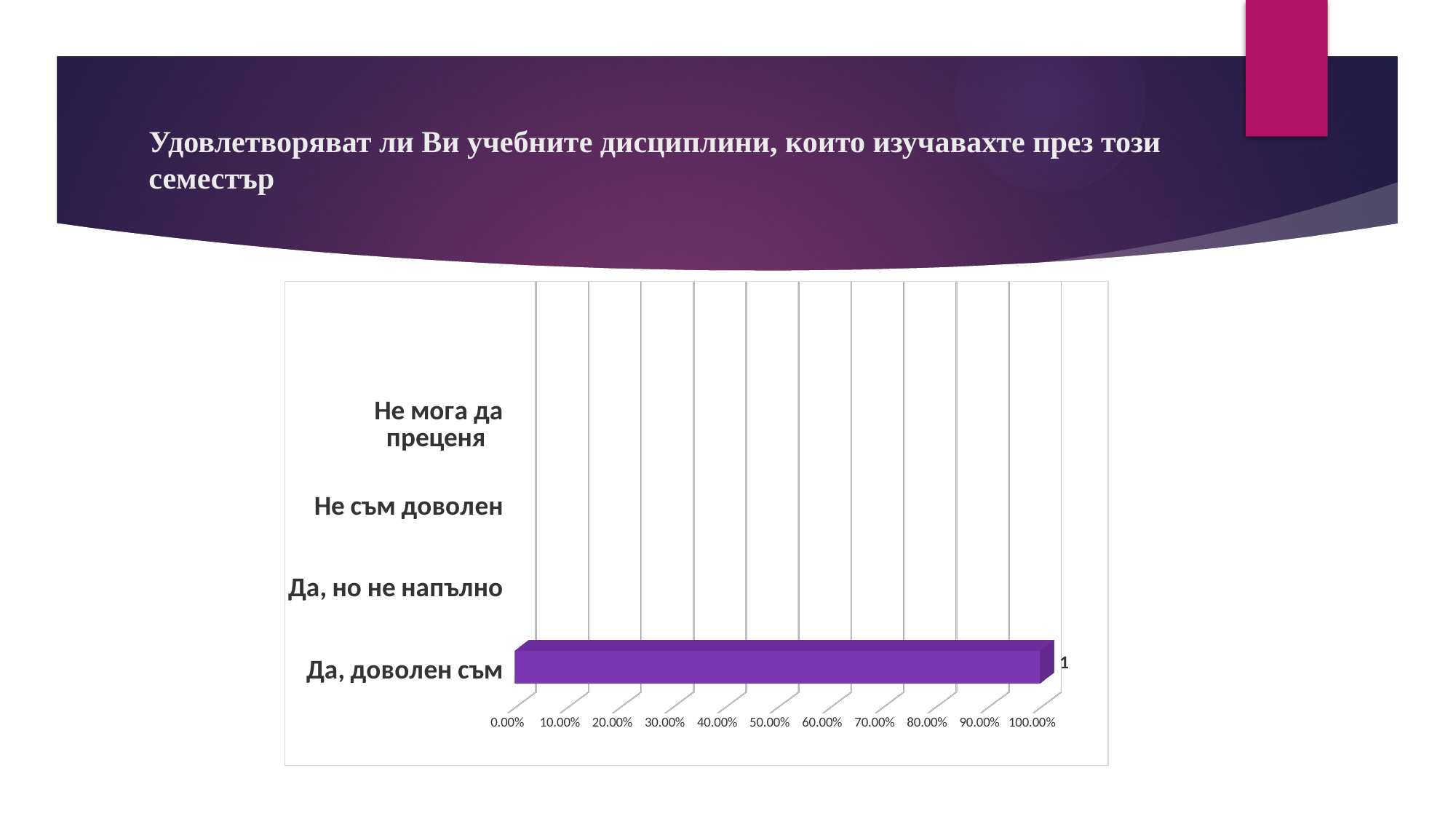
Which is larger, the value for "Да, доволен съм" or the value for "Да, но не напълно"? Да, доволен съм Is the value for "Да, доволен съм" greater or less than 90.00%? greater What is the highest tick label shown on the horizontal axis? 100.00% What data label is printed next to the bar for "Да, доволен съм"? 1 Which is larger, the value for "Да, доволен съм" or the value for "Не съм доволен"? Да, доволен съм How many categories on the chart have a visible bar? 1 What kind of chart is shown on the slide? bar chart Which category has the highest value on the chart? Да, доволен съм Is the value for "Да, доволен съм" greater or less than 50.00%? greater How many categories are listed on the chart's vertical axis? 4 What is the title of the slide above the chart? Удовлетворяват ли Ви учебните дисциплини, които изучавахте през този семестър